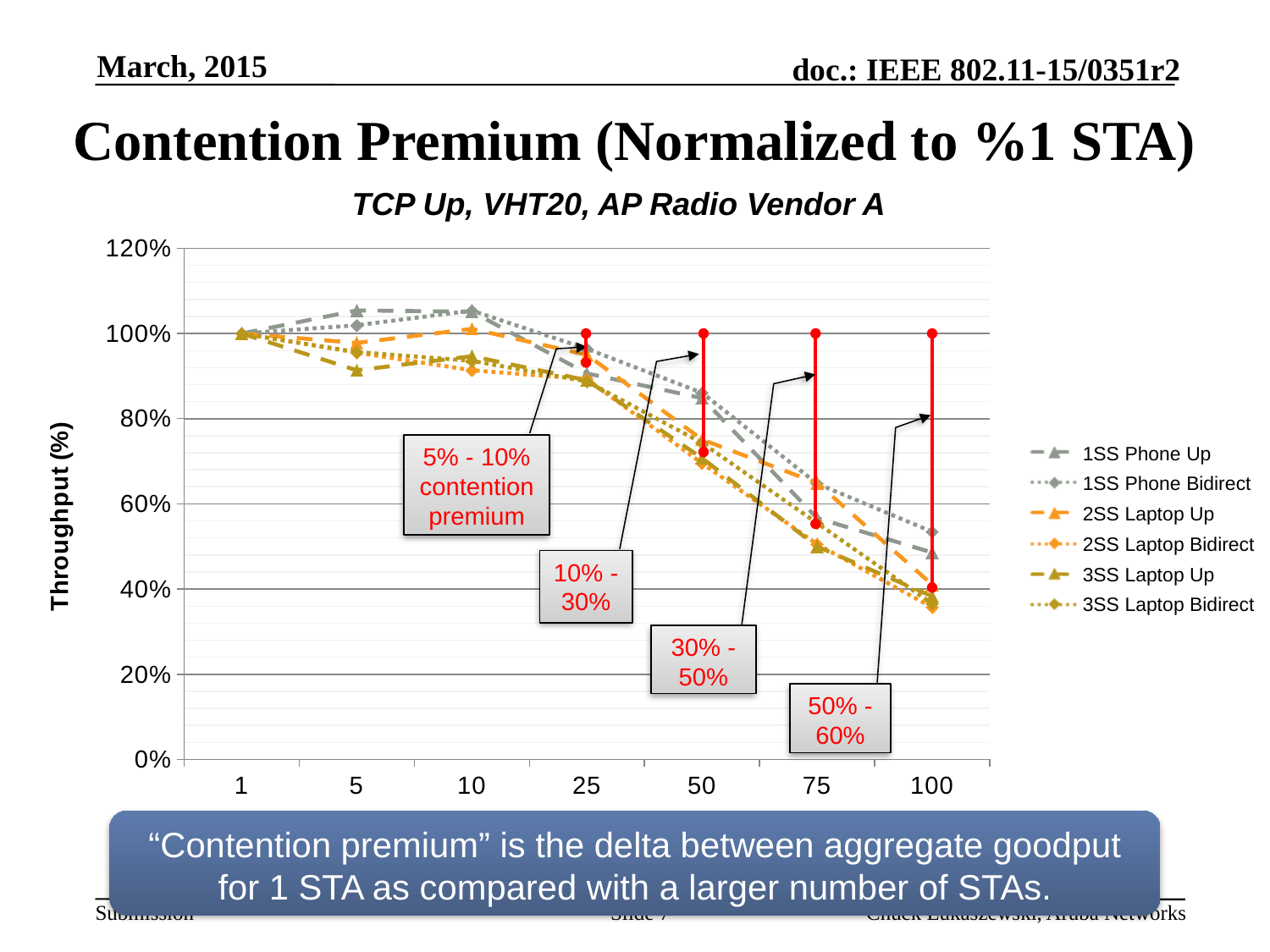
How many series does the legend list? 6 Is the value for 3SS Laptop Up at 5 STAs greater or less than 100%? less Do the throughput values generally rise or fall as the number of STAs increases along the x axis? fall What contention premium range does the annotation at 100 STAs show? 50% - 60% Is the value for 3SS Laptop Up at 100 STAs greater or less than 60%? less At 100 STAs, which is larger: 1SS Phone Bidirect or 3SS Laptop Up? 1SS Phone Bidirect How many points are on the x axis of the chart? 7 Is the value for 1SS Phone Bidirect at 50 STAs greater or less than 80%? greater What is the subtitle shown above the chart? TCP Up, VHT20, AP Radio Vendor A What is the throughput value for 1SS Phone Up at 1 STA? 100% What kind of chart is shown on the slide? line chart